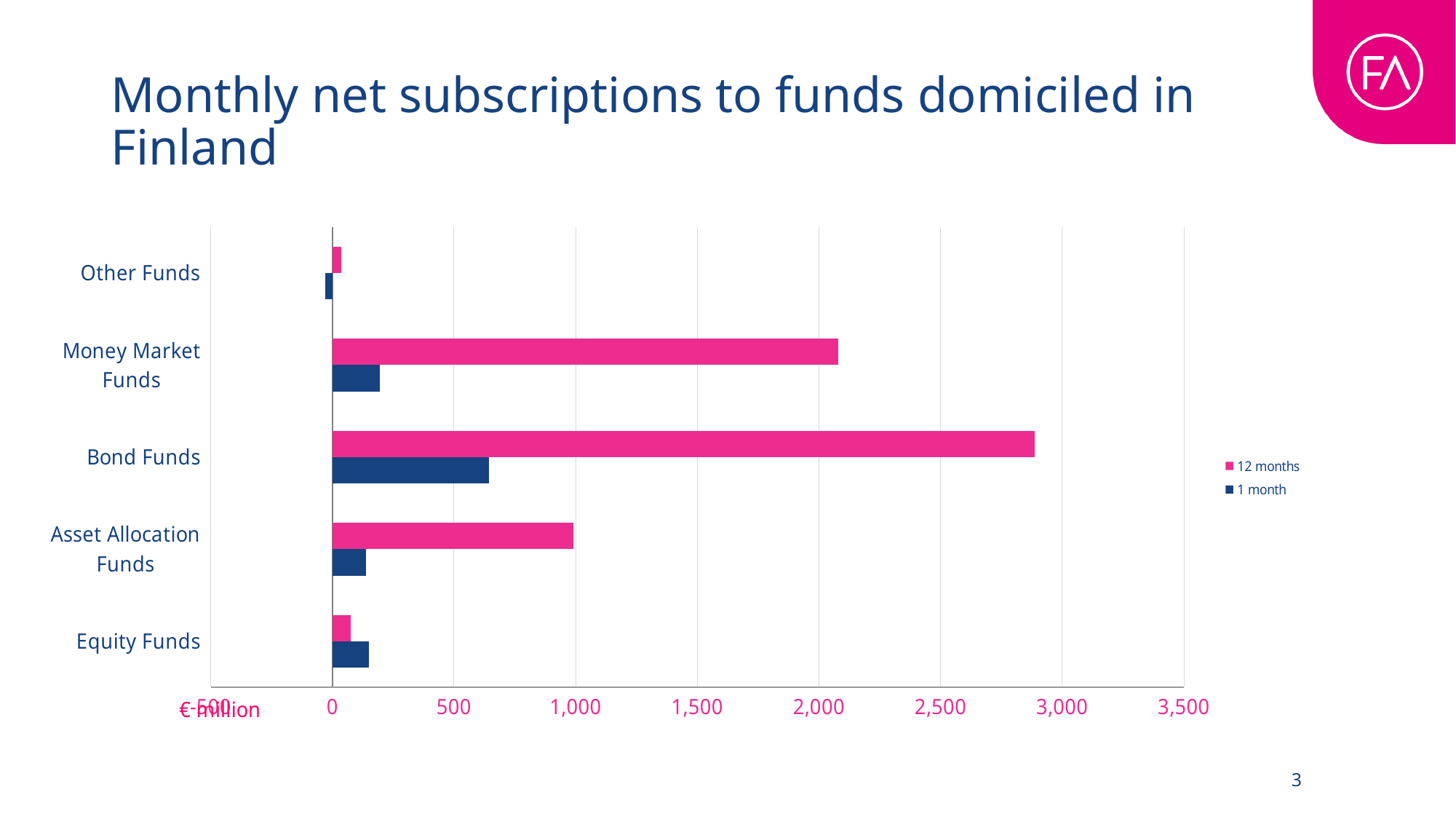
What kind of chart is shown on the slide? bar chart Is the 1 month value for Bond Funds greater or less than 500? greater Which series is shown in pink in the legend? 12 months Is the 12 months value for Bond Funds greater or less than 2,500? greater How many fund categories are shown on the chart? 5 For Equity Funds, which is larger: the 12 months value or the 1 month value? 1 month Is the 1 month value for Equity Funds greater or less than 500? less How many series does the legend list? 2 Which fund category has the highest 12 months value? Bond Funds Which fund category has the lowest 1 month value? Other Funds Which fund category has the highest 1 month value? Bond Funds